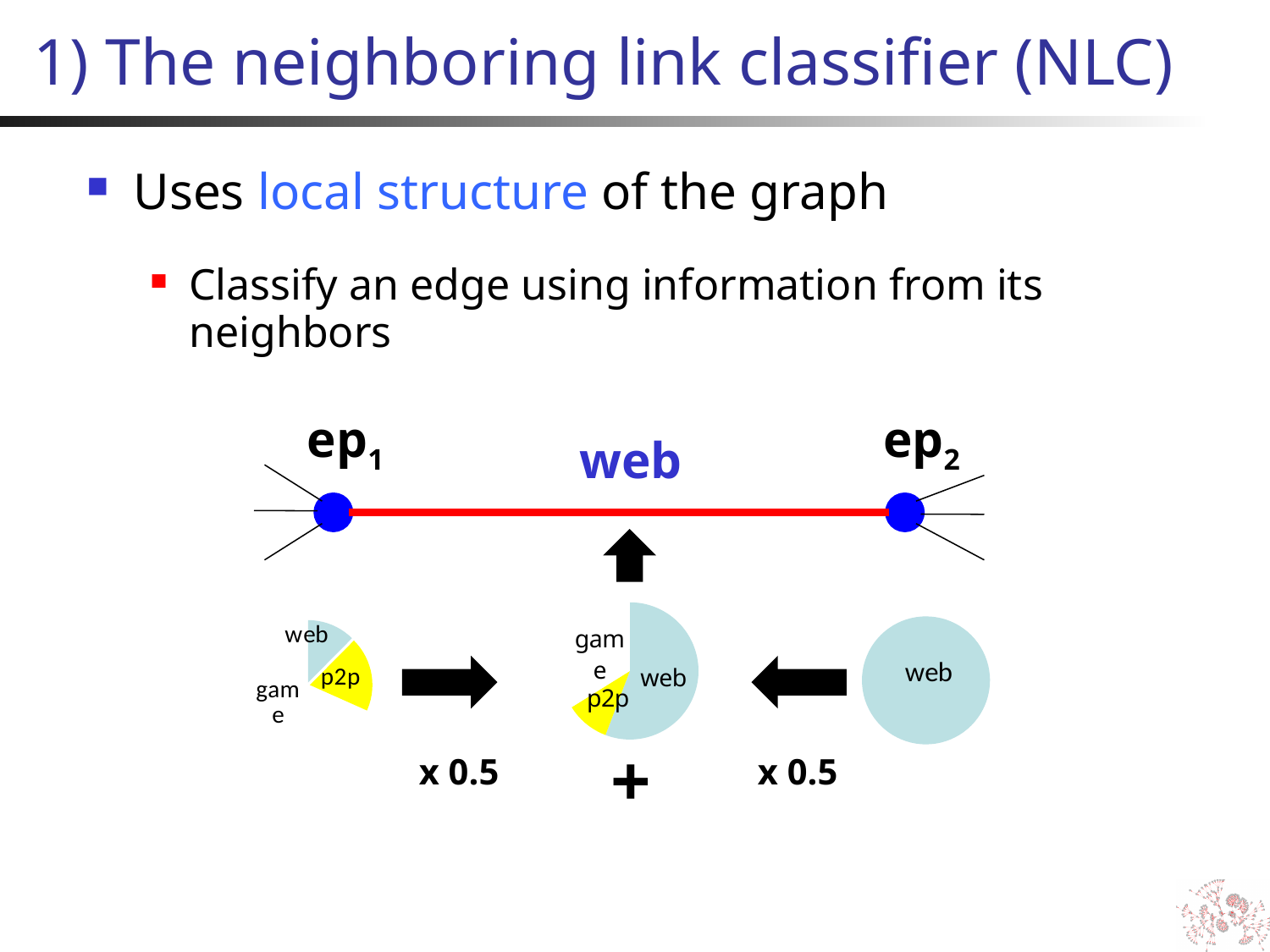
In the middle pie chart, which slice is larger, web or p2p? web How many categories are labeled in the left pie chart? 3 How many pie charts are shown on the slide? 3 What kind of charts are shown in the lower part of the slide? pie charts What colour is the web slice in the pie charts? light blue In the left pie chart (next to ep1), which slice is larger, p2p or web? p2p How many categories are labeled in the middle pie chart? 3 What colour is the p2p slice in the pie charts? yellow In the middle pie chart (above the plus sign), which category has the largest slice? web In the right pie chart (next to ep2), which category makes up the entire pie? web